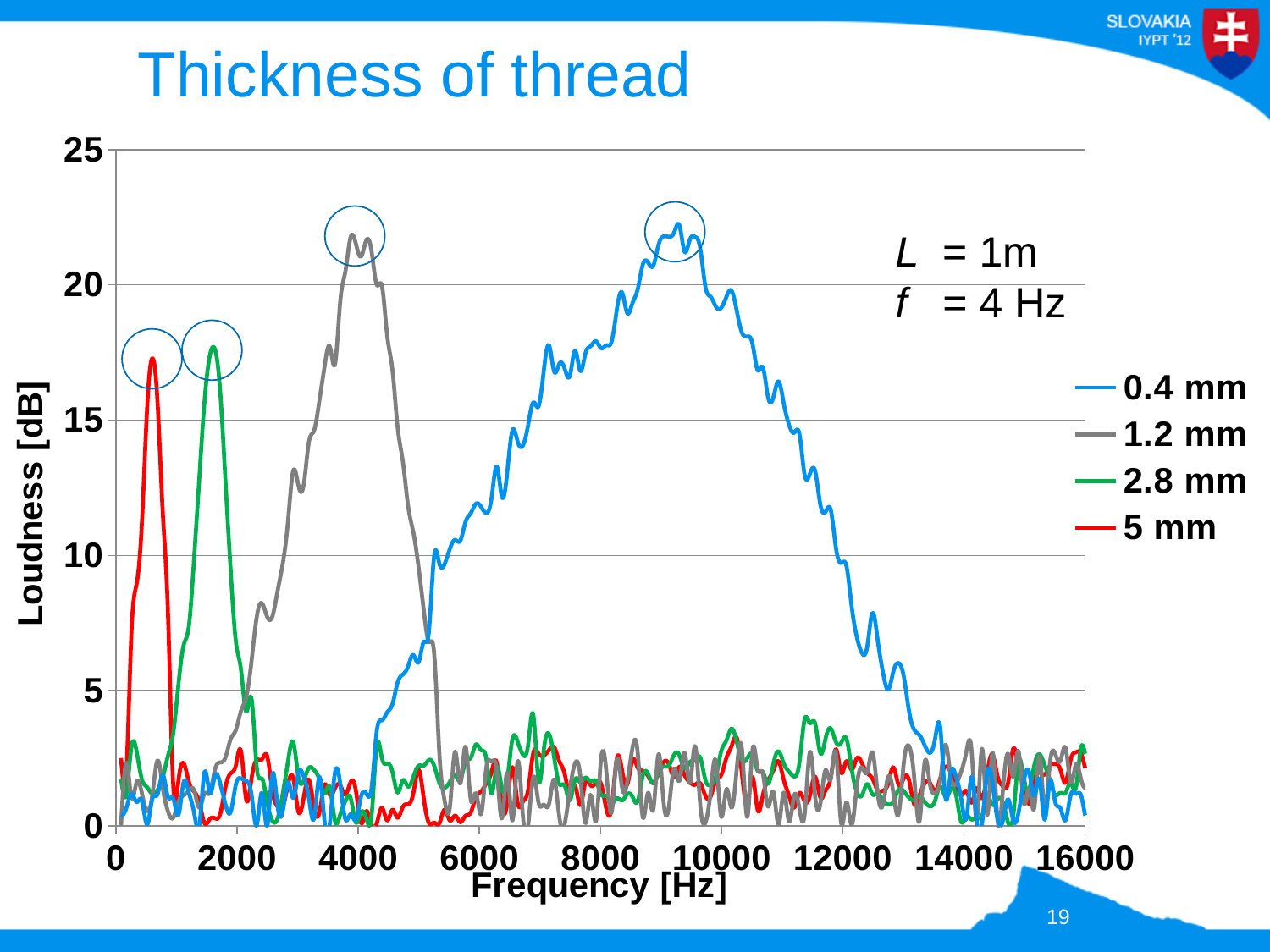
What colour is the line for the 0.4 mm thread? Blue What is the maximum value shown on the Frequency axis? 16000 How many series does the legend list? 4 Which series reaches a higher peak loudness, 1.2 mm or 5 mm? 1.2 mm Is the peak loudness of the 5 mm series greater or less than 15 dB? greater Is the peak loudness of the 0.4 mm series greater or less than 20 dB? greater Which series has its peak at the highest frequency? 0.4 mm Which thread thicknesses are listed in the legend? 0.4 mm, 1.2 mm, 2.8 mm, 5 mm Which series has its peak at the lowest frequency? 5 mm What kind of chart is shown on the slide? Line chart As the thread thickness increases, does the frequency of the peak rise or fall? Fall Is the peak loudness of the 2.8 mm series greater or less than 20 dB? less